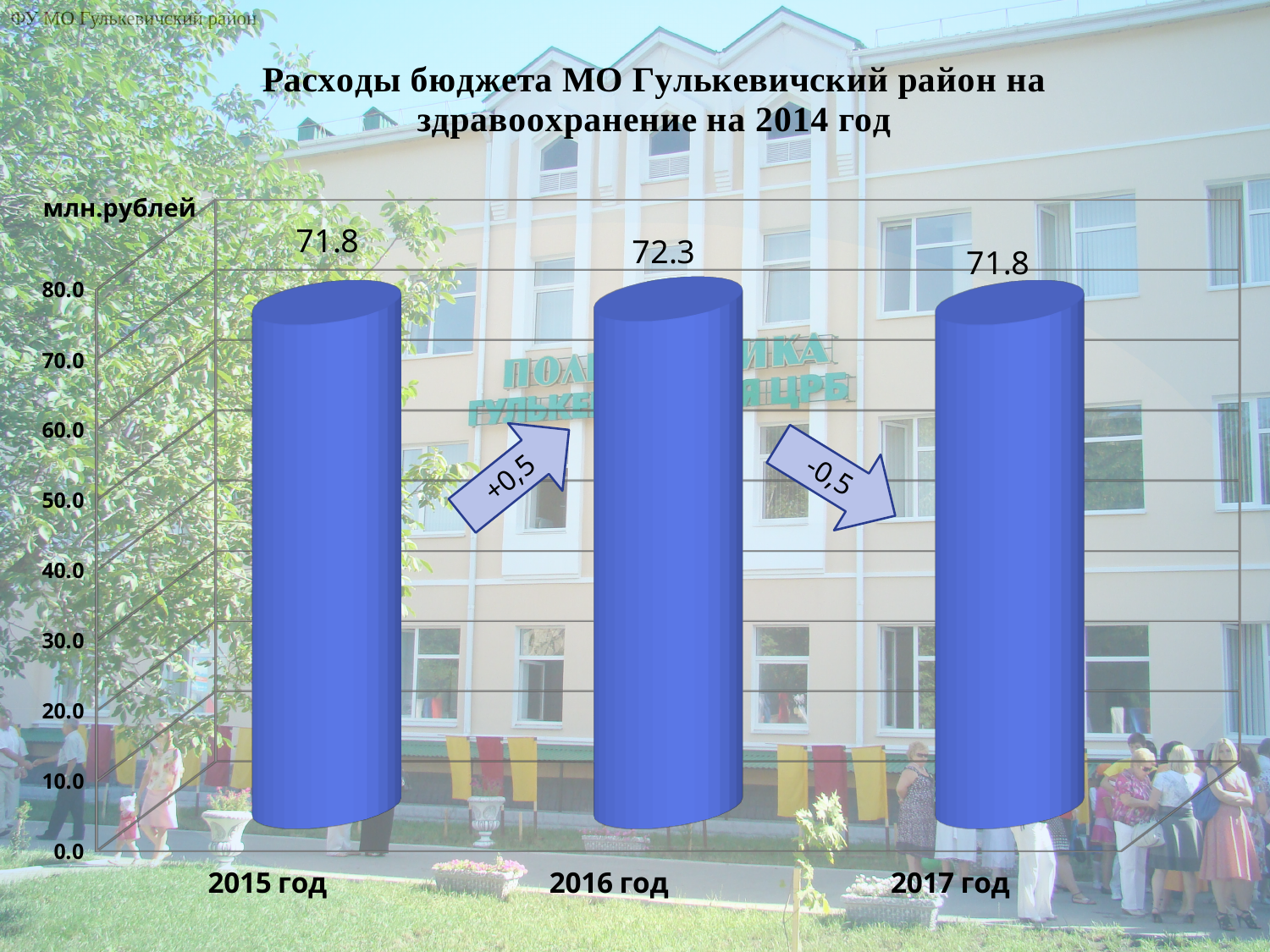
Is the value for 2015 год greater or less than 70.0? greater Do the values rise or fall from 2016 год to 2017 год? fall What is the value for 2015 год? 71.8 Which is larger, the value for 2016 год or the value for 2017 год? 2016 год What is the value for 2017 год? 71.8 What kind of chart is shown on the slide? bar chart What is the value for 2016 год? 72.3 What is the difference between the values for 2016 год and 2015 год? 0.5 Is the value for 2016 год greater or less than 80.0? less How many years are shown on the chart? 3 What unit is shown on the vertical axis of the chart? млн.рублей Which year has the highest value? 2016 год